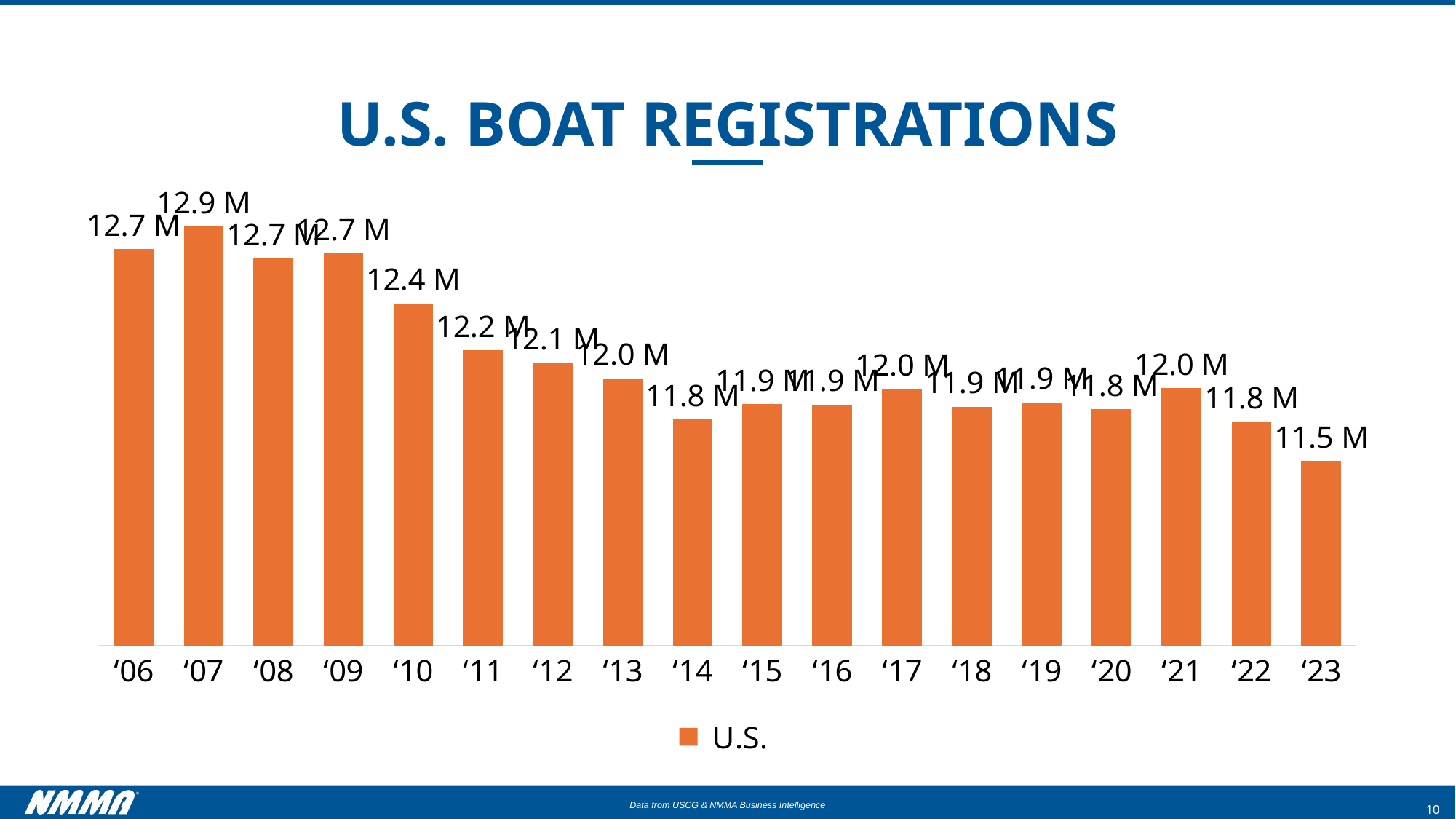
Which year has the highest number of U.S. boat registrations? '07 What is the value of U.S. boat registrations for '17? 12.0 M Which is larger, the value for '10 or the value for '14? '10 How many years are shown on the x axis of the chart? 18 What is the value of U.S. boat registrations for '10? 12.4 M What is the value of U.S. boat registrations for '23? 11.5 M What type of chart is shown on the slide? Bar chart What is the value of U.S. boat registrations for '07? 12.9 M What is the difference between the '07 value and the '23 value? 1.4 M Do U.S. boat registrations generally rise or fall from '06 to '23? Fall Which year has the lowest number of U.S. boat registrations? '23 How many series does the legend list? 1